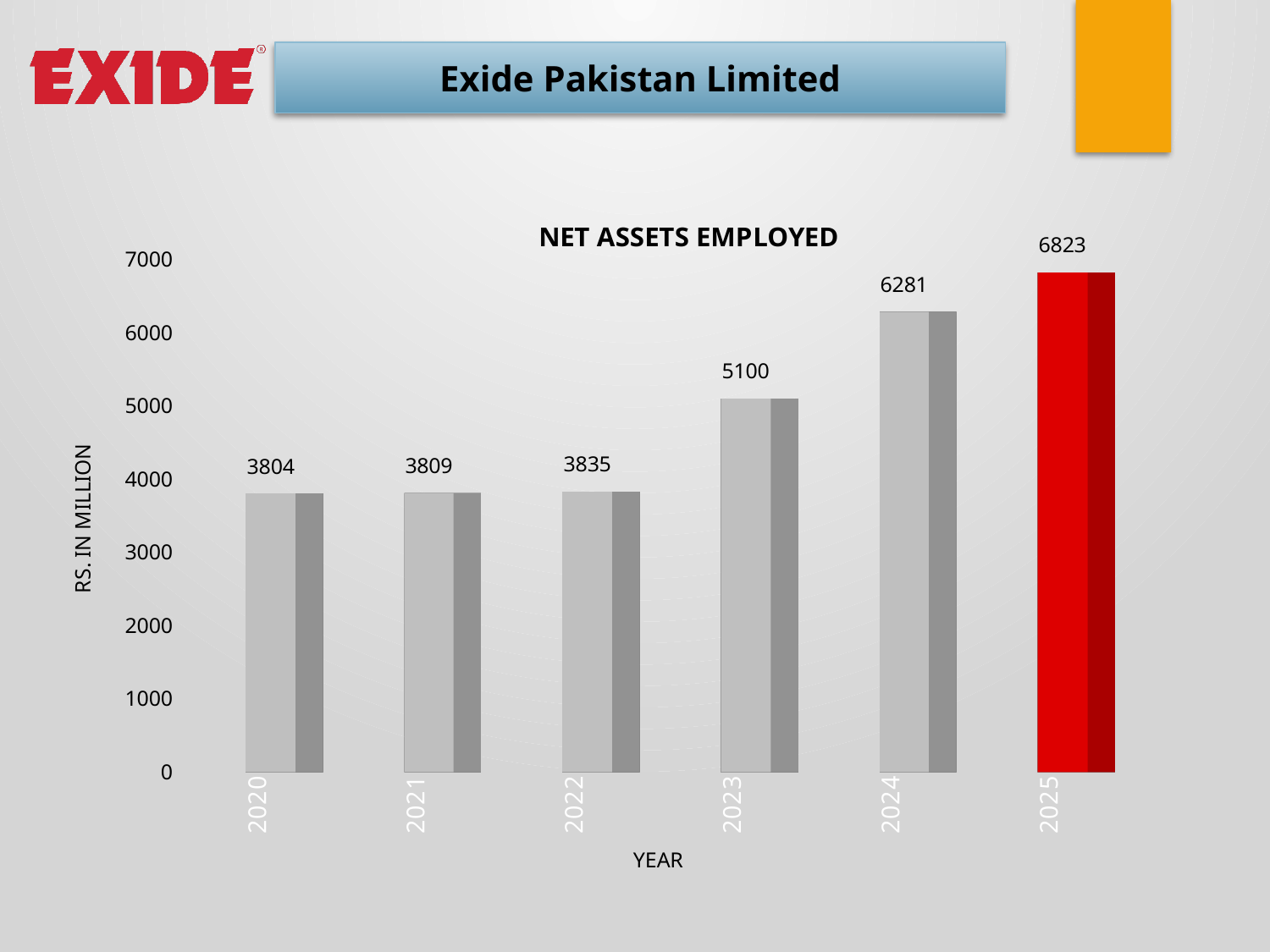
What is the value of net assets employed for 2025? 6823 How many years are shown on the chart? 6 Which year has larger net assets employed, 2023 or 2024? 2024 What is the difference in net assets employed between 2025 and 2024? 542 What is the difference in net assets employed between 2023 and 2022? 1265 Do the net assets employed values rise or fall from 2020 to 2025? Rise Is the value for 2024 greater or less than 6000? greater What is the value of net assets employed for 2023? 5100 Which year has the lowest net assets employed? 2020 What kind of chart is shown on the slide? Bar chart Which year has the highest net assets employed? 2025 What is the value of net assets employed for 2022? 3835